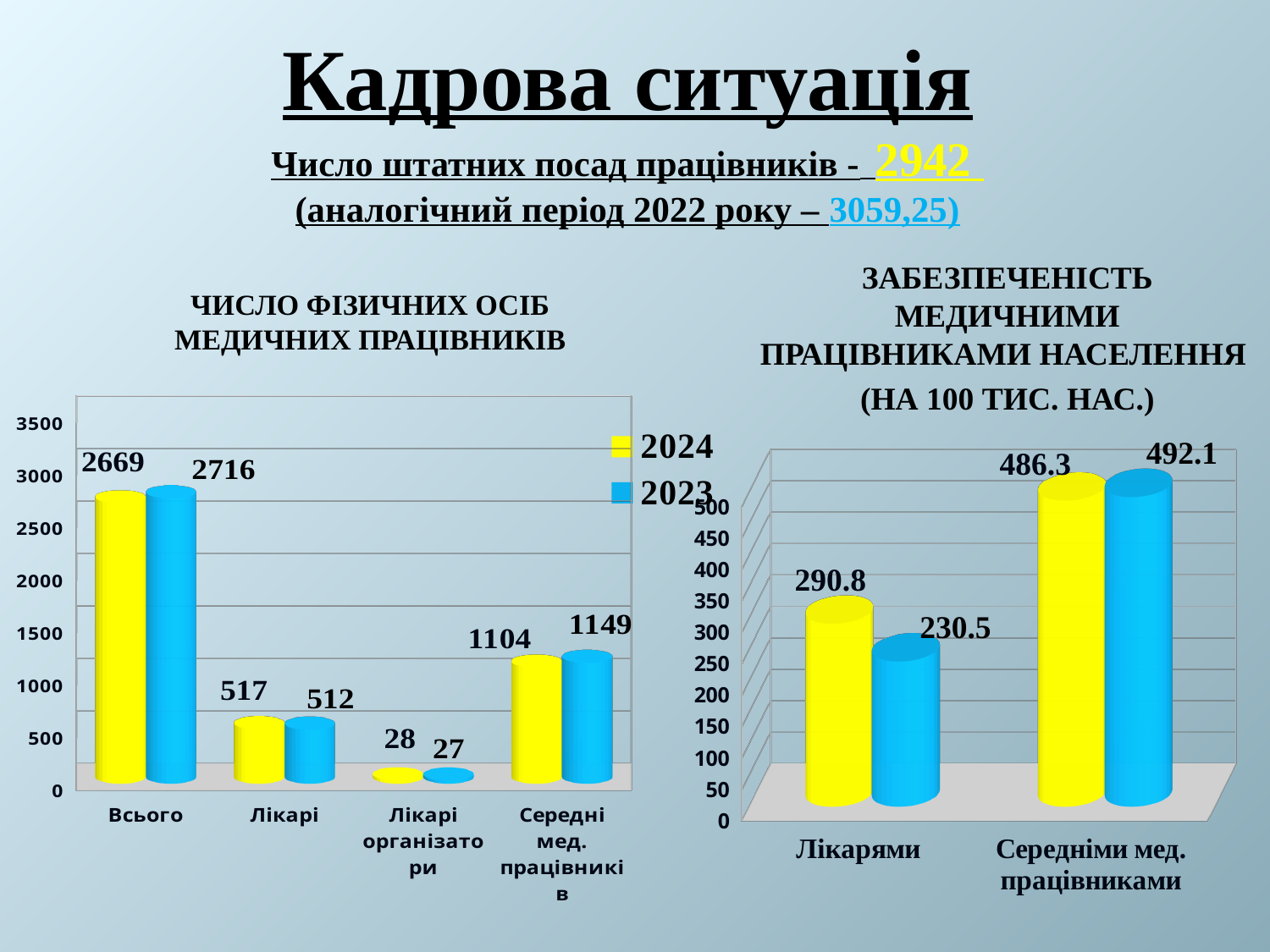
In the right chart (ЗАБЕЗПЕЧЕНІСТЬ МЕДИЧНИМИ ПРАЦІВНИКАМИ НАСЕЛЕННЯ), what is the value of the blue bar for Середніми мед. працівниками? 492.1 In the right chart (ЗАБЕЗПЕЧЕНІСТЬ МЕДИЧНИМИ ПРАЦІВНИКАМИ НАСЕЛЕННЯ), what is the difference between the yellow and blue bars for Лікарями? 60.3 In the left chart (ЧИСЛО ФІЗИЧНИХ ОСІБ МЕДИЧНИХ ПРАЦІВНИКІВ), which category has the lowest values? Лікарі організатори In the left chart (ЧИСЛО ФІЗИЧНИХ ОСІБ МЕДИЧНИХ ПРАЦІВНИКІВ), how many categories are shown on the x axis? 4 In the right chart (ЗАБЕЗПЕЧЕНІСТЬ МЕДИЧНИМИ ПРАЦІВНИКАМИ НАСЕЛЕННЯ), what is the value of the yellow bar for Лікарями? 290.8 What kind of chart is the right chart (ЗАБЕЗПЕЧЕНІСТЬ МЕДИЧНИМИ ПРАЦІВНИКАМИ НАСЕЛЕННЯ)? Bar chart